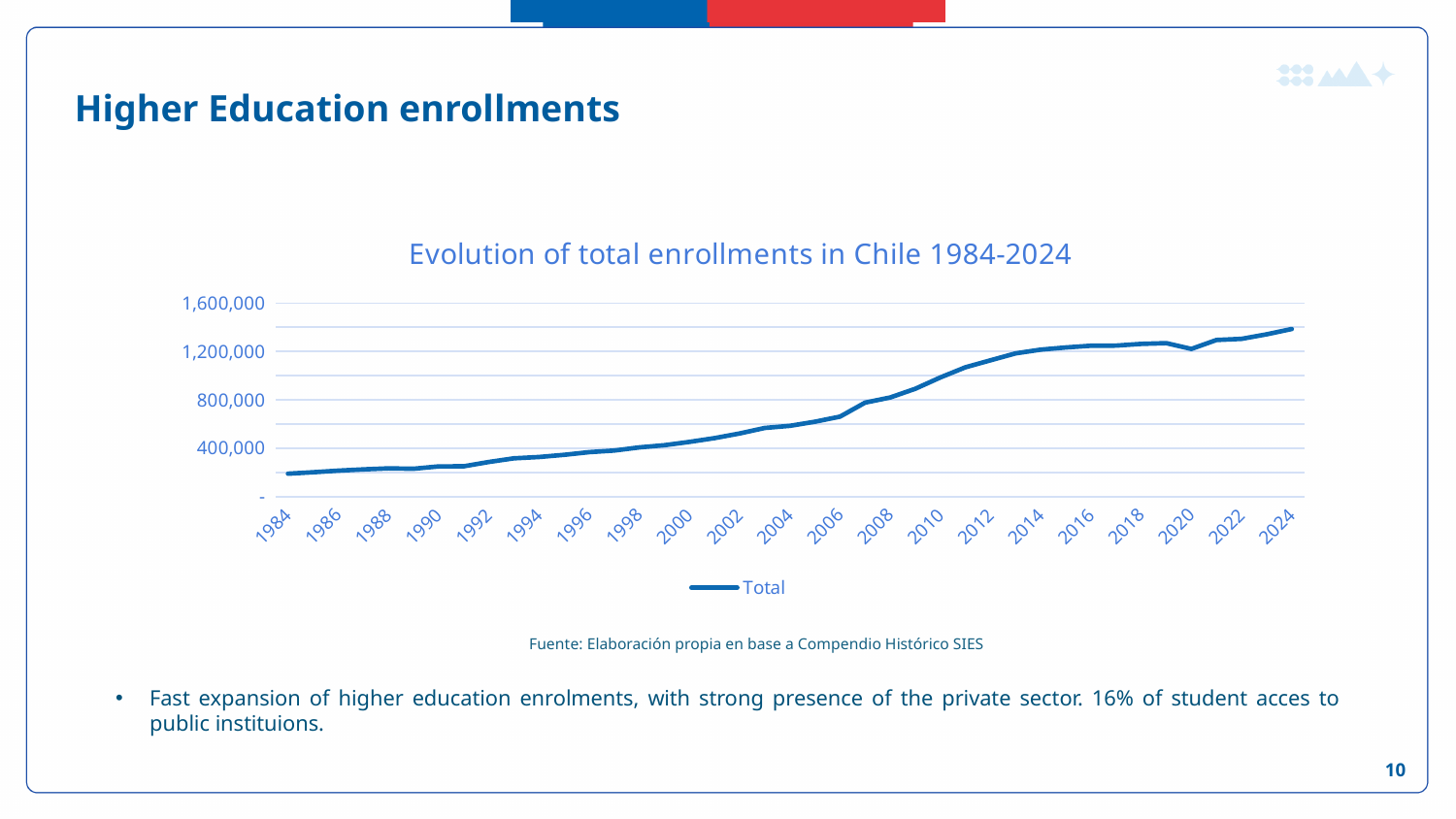
In which year is the total enrollment highest? 2024 Do total enrollments generally rise or fall from 1984 to 2024? rise Is the value for 1984 greater or less than 400,000? less Is the value for 2024 greater or less than 1,200,000? greater What kind of chart is shown on the slide? line chart How many series does the chart legend list? 1 In which year is the total enrollment lowest? 1984 Is the value for 2010 greater or less than 800,000? greater What is the title of the chart? Evolution of total enrollments in Chile 1984-2024 Which year has the larger total enrollment, 2000 or 2010? 2010 What is the name of the series shown in the chart legend? Total